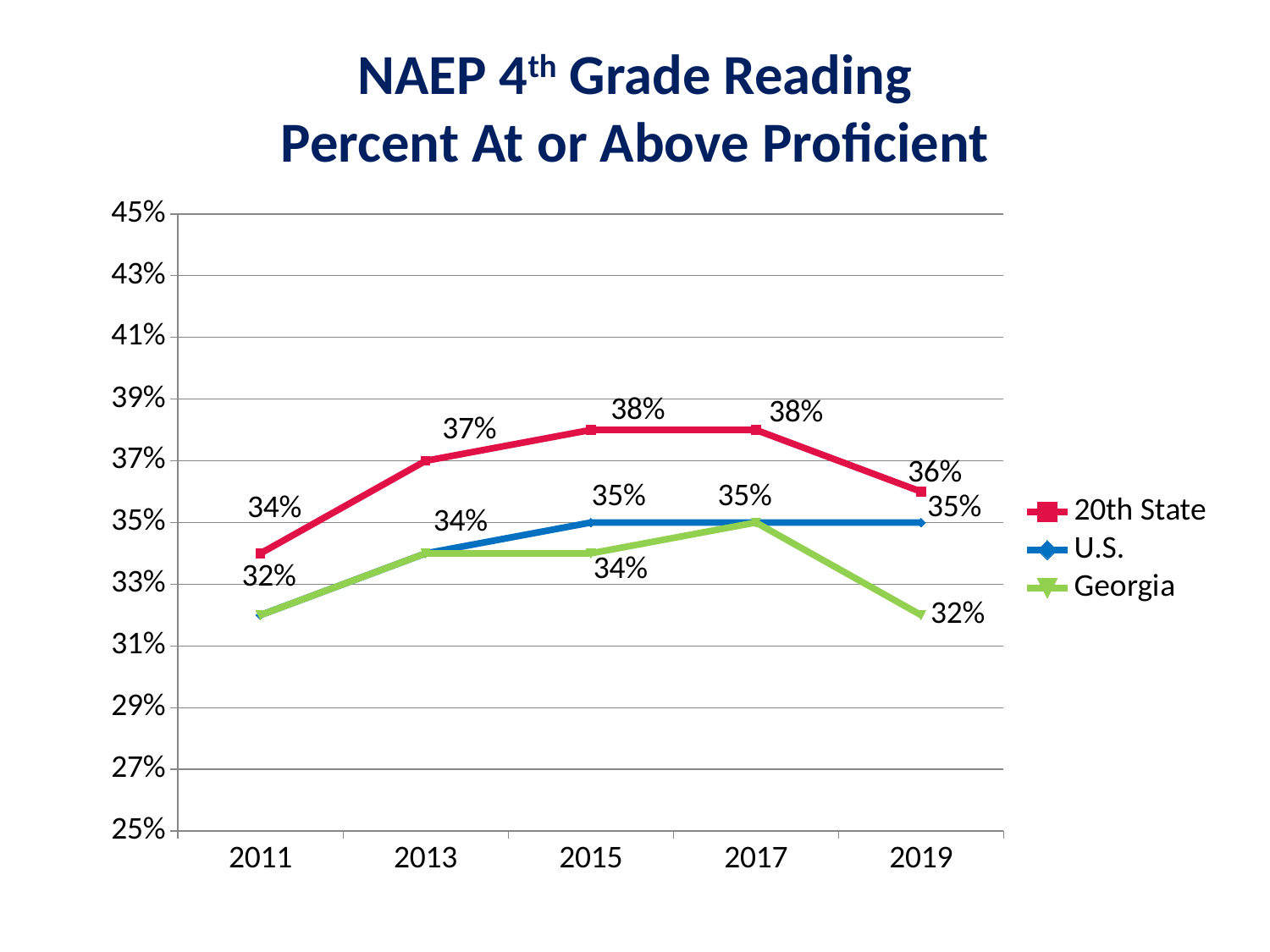
Is the 20th State value for 2017 greater or less than 37%? greater In 2013, which is larger: the 20th State value or Georgia's value? 20th State Does the 20th State value rise or fall from 2017 to 2019? fall How many series does the legend list? 3 What is the 20th State value for 2015? 38% How many years are shown on the x axis? 5 What is Georgia's value for 2019? 32% What kind of chart is shown on the slide? line chart In which year is Georgia's value highest? 2017 In which year is the 20th State value lowest? 2011 What is the U.S. value for 2017? 35% What is the difference between the 20th State value and Georgia's value in 2019? 4 percentage points